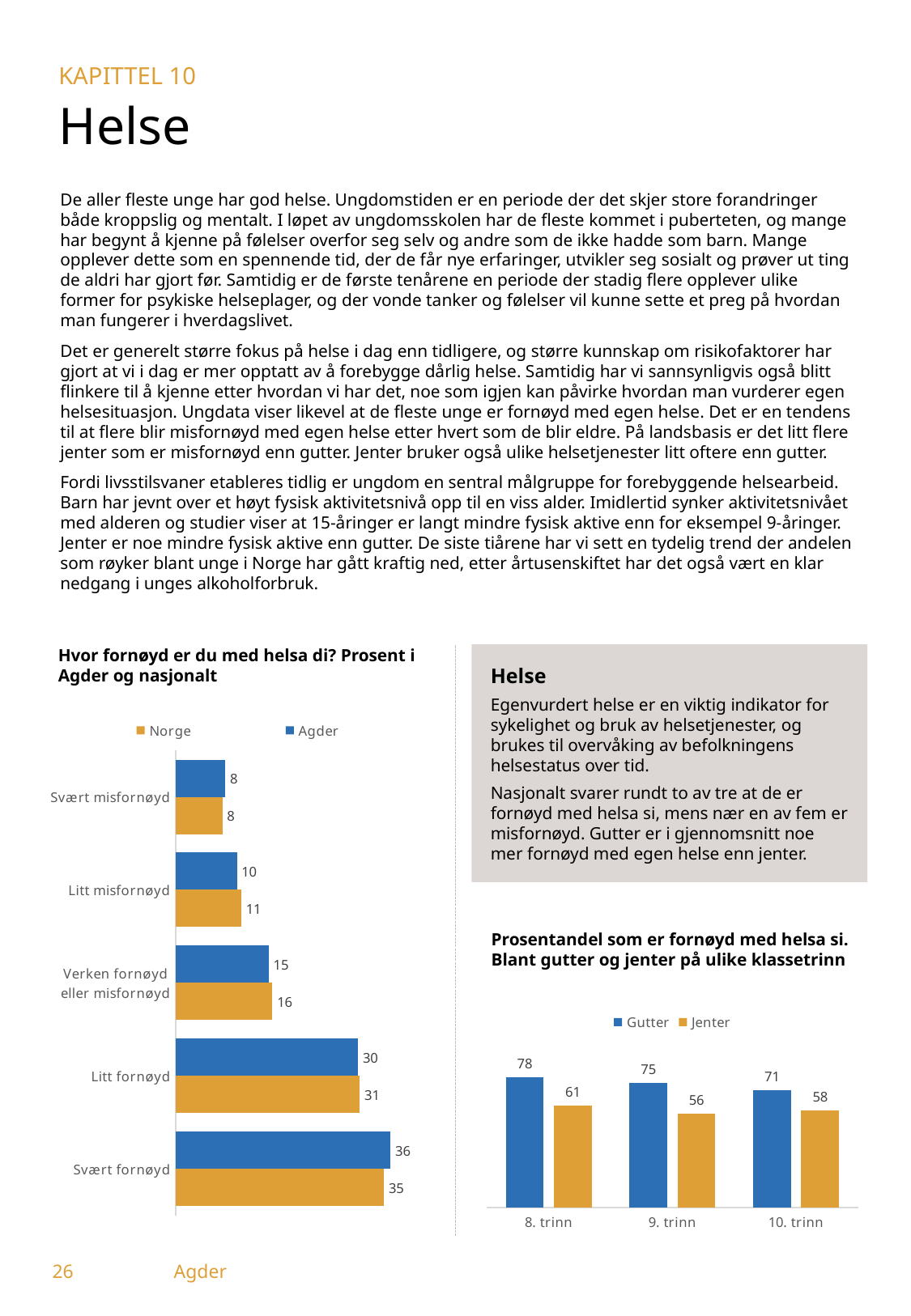
In the chart 'Hvor fornøyd er du med helsa di?', which category has the highest Norge value? Svært fornøyd In the chart 'Prosentandel som er fornøyd med helsa si', what is the Gutter value for 9. trinn? 75 What kind of chart is 'Hvor fornøyd er du med helsa di?'? Bar chart In the chart 'Prosentandel som er fornøyd med helsa si', what is the difference between Gutter and Jenter at 8. trinn? 17 In the chart 'Hvor fornøyd er du med helsa di?', what is the difference between the Norge and Agder values for 'Litt fornøyd'? 1 In the chart 'Hvor fornøyd er du med helsa di?', how many series does the legend list? 2 In the chart 'Hvor fornøyd er du med helsa di?', how many categories are shown on the vertical axis? 5 In the chart 'Prosentandel som er fornøyd med helsa si', what is the Jenter value for 10. trinn? 58 In the chart 'Hvor fornøyd er du med helsa di?', what is the Norge value for 'Litt misfornøyd'? 11 In the chart 'Hvor fornøyd er du med helsa di?', what is the Agder value for 'Svært fornøyd'? 36 In the chart 'Prosentandel som er fornøyd med helsa si', do the Gutter values rise or fall from 8. trinn to 10. trinn? Fall In the chart 'Prosentandel som er fornøyd med helsa si', which klassetrinn has the lowest Jenter value? 9. trinn